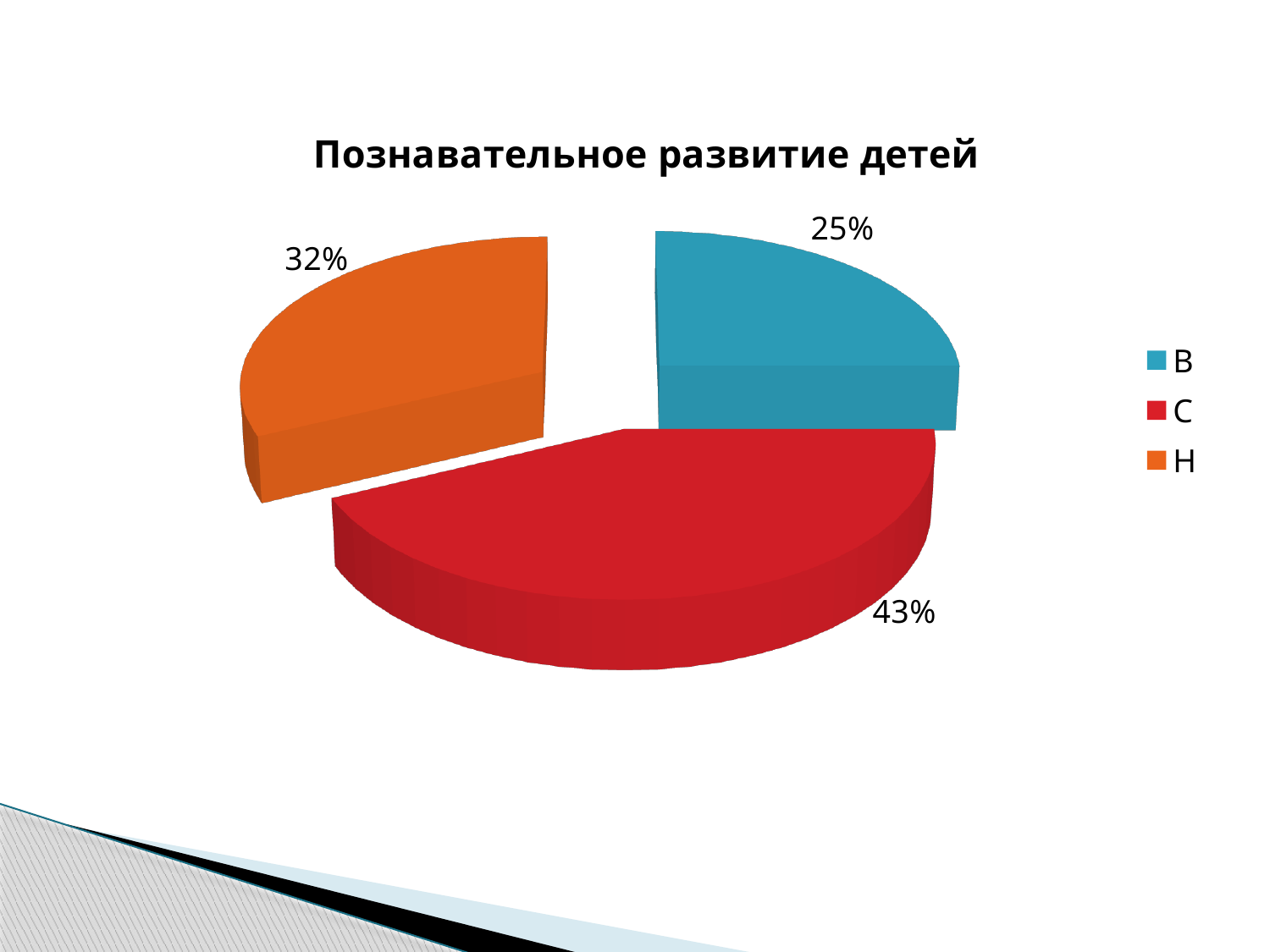
What kind of chart is shown on the slide? pie chart Which category has the smallest share of the pie? В Which category has the largest share of the pie? С What percentage is shown for the В slice? 25% How many slices does the pie chart have? 3 What percentage is shown for the Н slice? 32% What is the title of the chart? Познавательное развитие детей Which is larger, the share for Н or the share for В? Н What percentage is shown for the С slice? 43% How many entries does the legend list? 3 What colour is the slice for С? red What is the difference in percentage points between the С slice and the В slice? 18